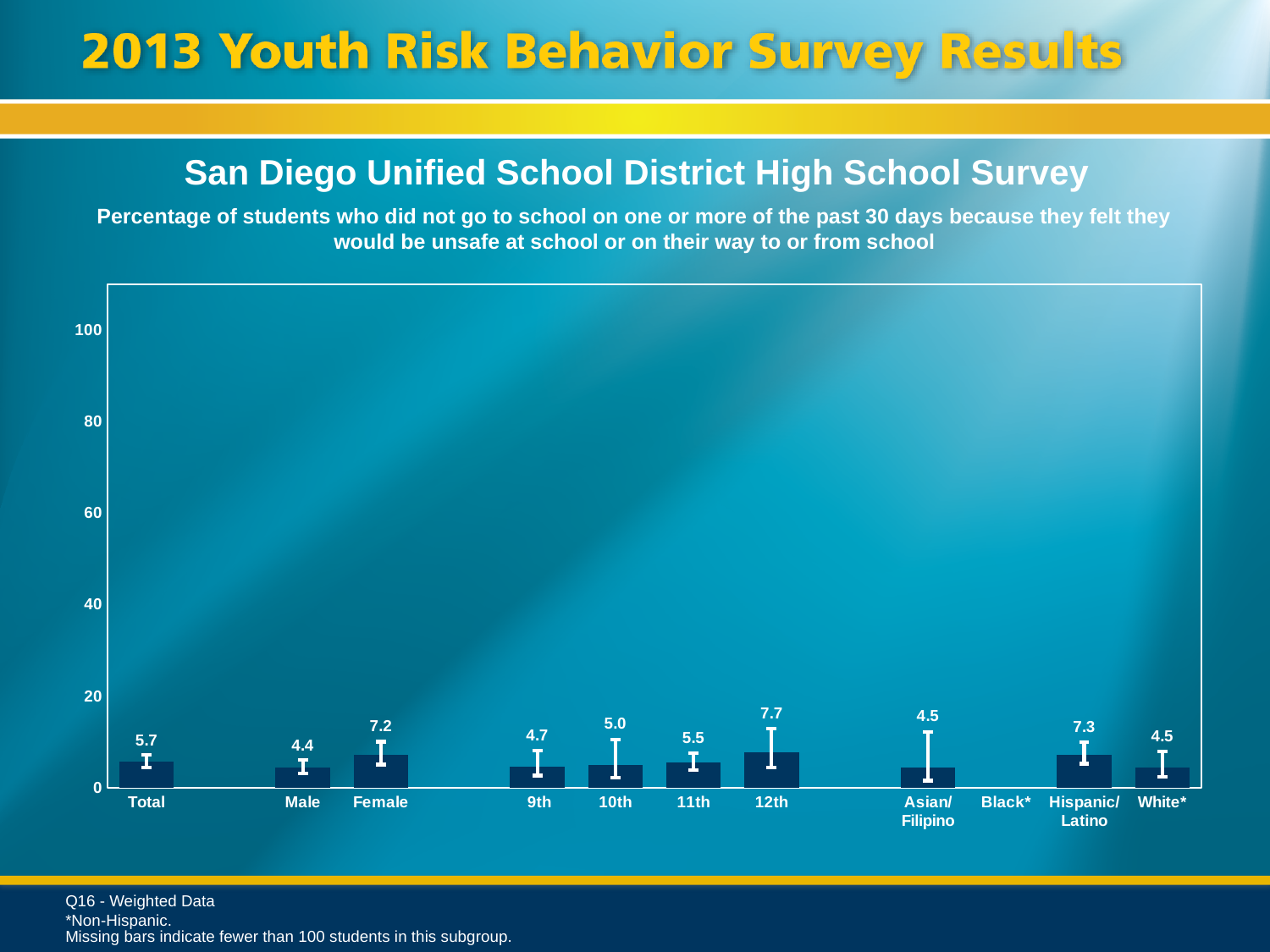
Which is larger, the value for Male or the value for Female? Female What is the value for Female? 7.2 What is the value for 12th grade? 7.7 Which category has the highest value? 12th What is the difference between the Female and Male values? 2.8 What is the value for Total? 5.7 What is the value for Hispanic/Latino? 7.3 What is the difference between the 12th and 9th grade values? 3.0 Which category has the lowest value among the bars shown? Male Do the values rise or fall from 9th grade to 12th grade? rise What kind of chart is shown on the slide? bar chart Is the value for 12th grade greater or less than 20? less